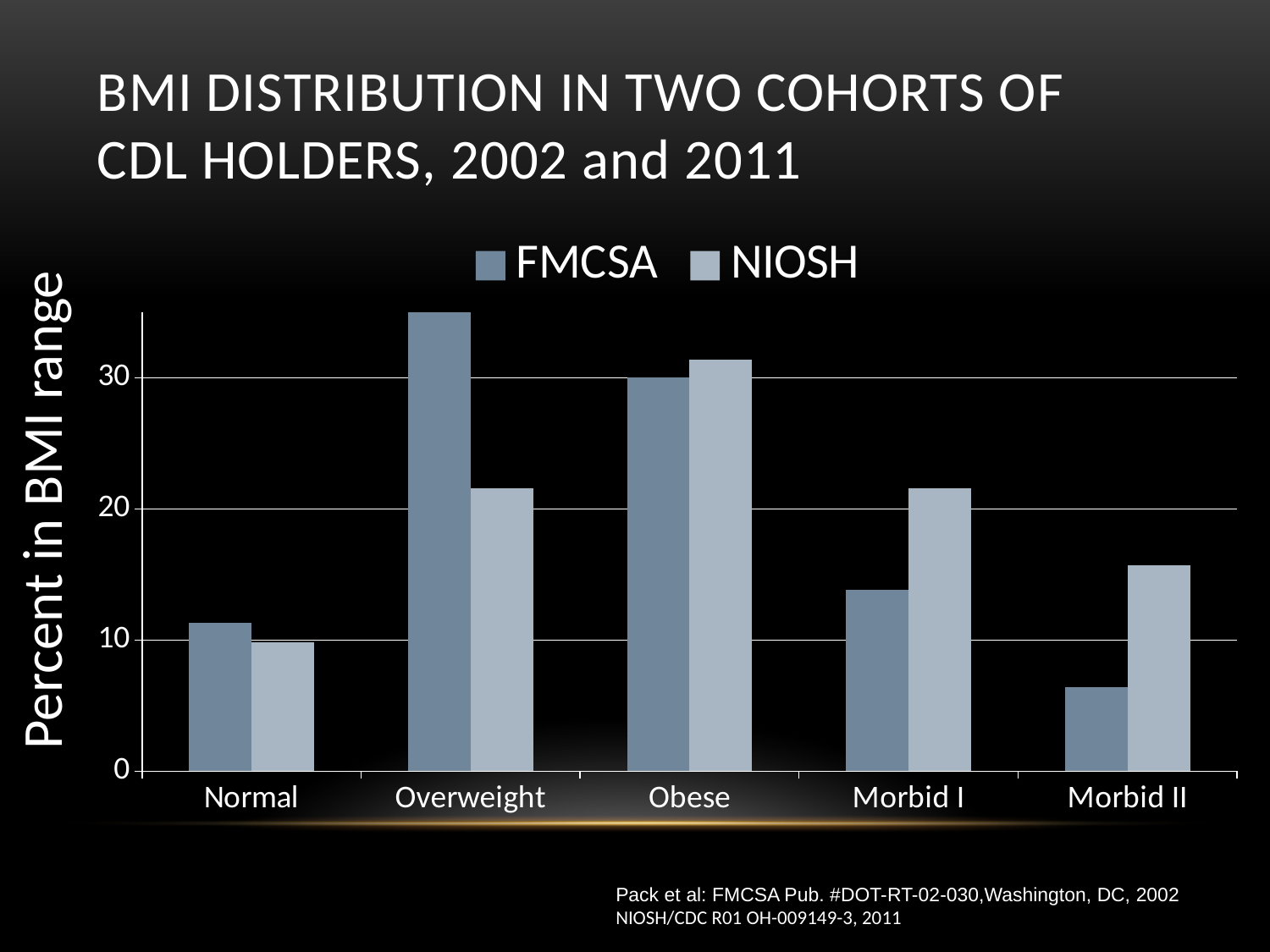
Which BMI category has the lowest NIOSH value? Normal How many series does the legend list? 2 For the Overweight category, which series has the larger value, FMCSA or NIOSH? FMCSA What kind of chart is shown on the slide? bar chart How many BMI categories are shown on the x axis? 5 Which BMI category has the highest FMCSA value? Overweight Is the FMCSA value for Morbid II greater or less than 10? less What is the label on the vertical axis of the chart? Percent in BMI range Is the FMCSA value for Overweight greater or less than 30? greater Is the NIOSH value for Morbid II greater or less than 20? less Which BMI category has the lowest FMCSA value? Morbid II For the Morbid II category, which series has the larger value, FMCSA or NIOSH? NIOSH